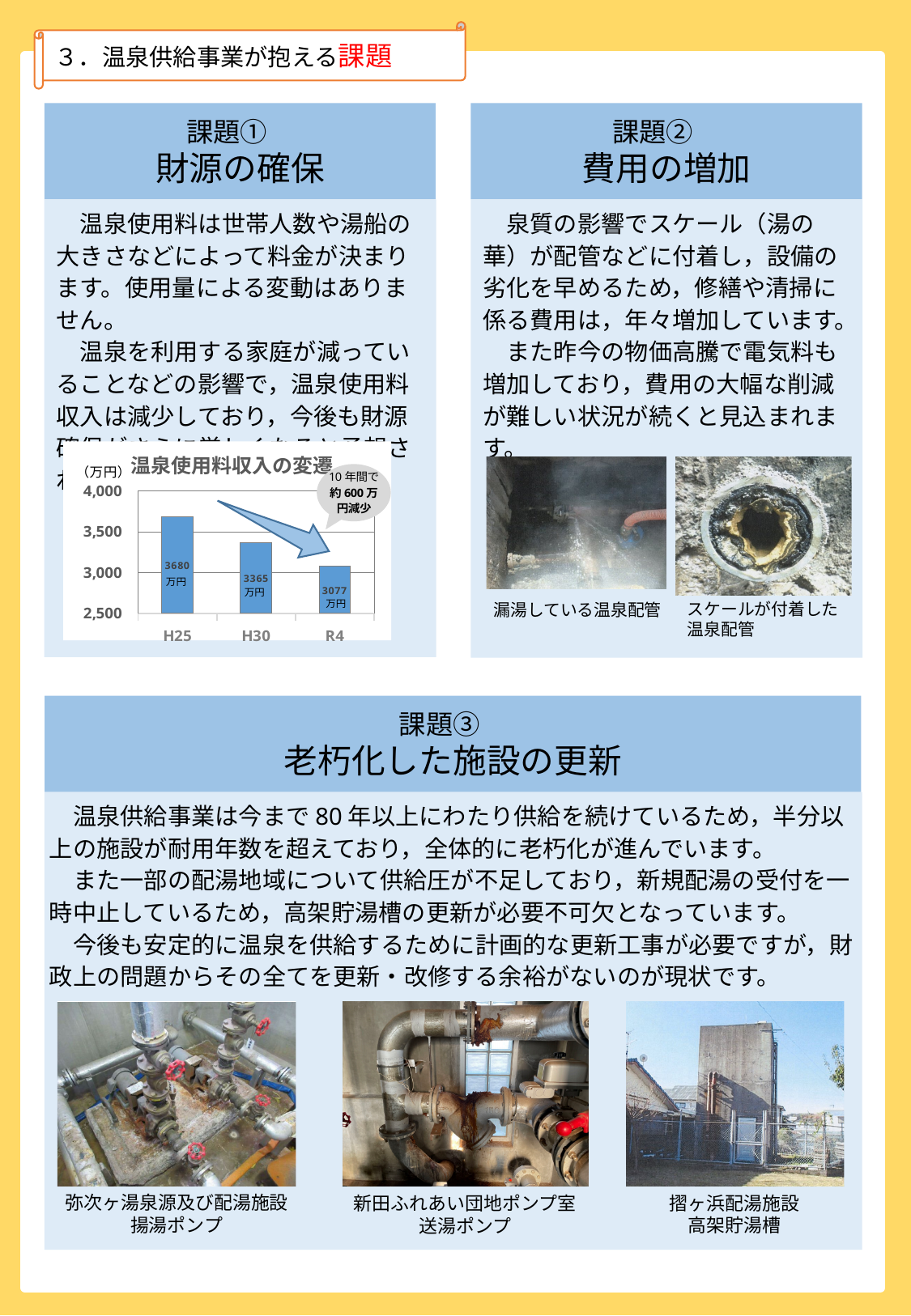
What type of chart is shown on the slide? bar chart What is the value for H30 in the chart? 3365万円 Which category has the lowest value in the chart? R4 Do the values in the chart rise or fall from H25 to R4? fall Which category has the highest value in the chart? H25 What is the title of the chart on the slide? 温泉使用料収入の変遷 Which is larger in the chart, the value for H30 or the value for R4? H30 What is the difference between the H25 and R4 values in the chart? 603万円 What is the difference between the H25 and H30 values in the chart? 315万円 What is the value for R4 in the chart? 3077万円 How many categories are shown on the x axis of the chart? 3 What is the value for H25 in the chart? 3680万円